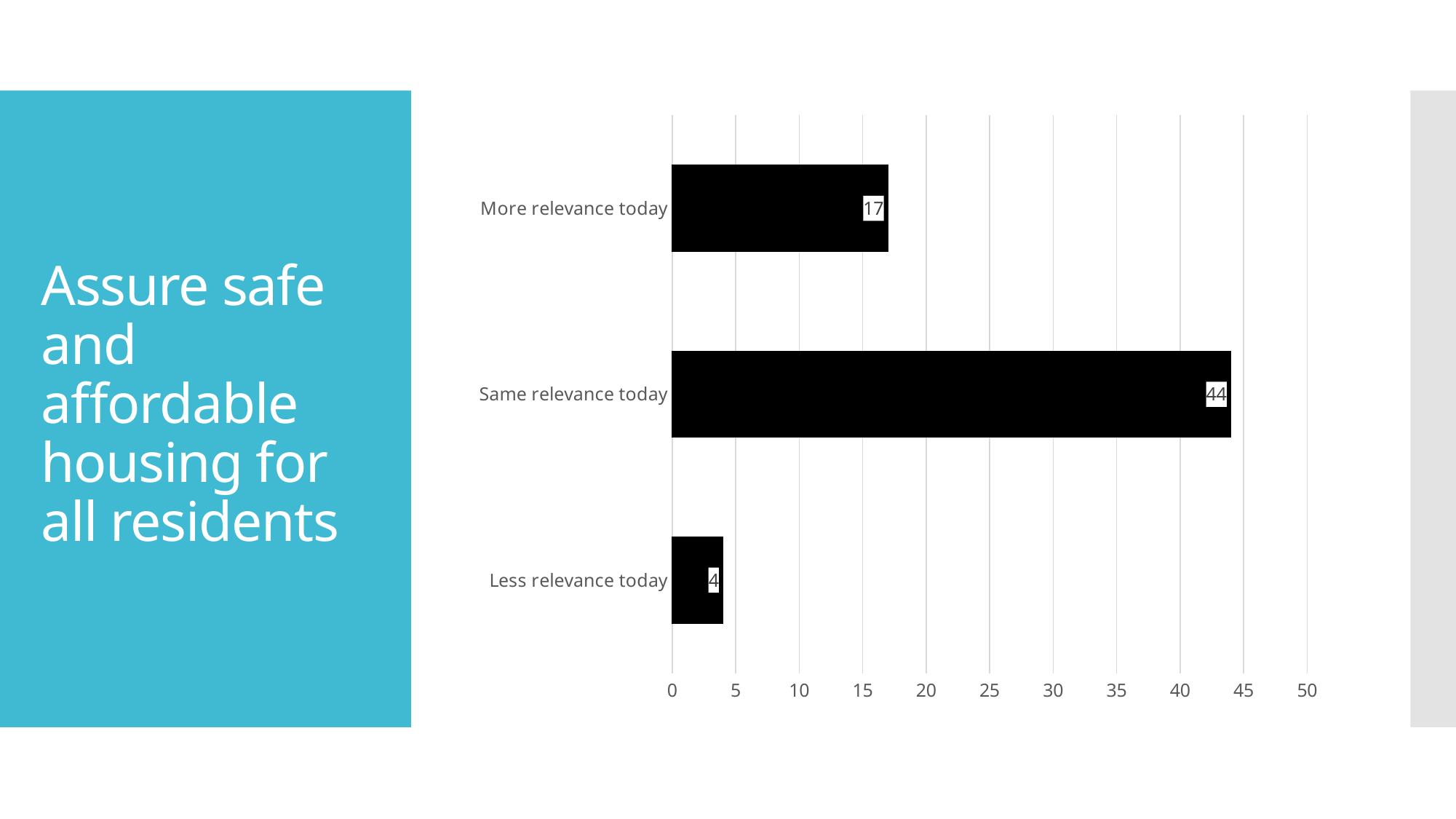
What is the value for "Less relevance today"? 4 What is the difference between the values for "More relevance today" and "Less relevance today"? 13 Which is larger, the value for "More relevance today" or "Less relevance today"? More relevance today What is the value for "More relevance today"? 17 How many categories are shown in the chart? 3 Is the value for "Same relevance today" greater or less than 40? greater Which category has the lowest value? Less relevance today What is the value for "Same relevance today"? 44 What is the difference between the values for "Same relevance today" and "More relevance today"? 27 Which category has the highest value? Same relevance today What is the highest value shown on the horizontal axis? 50 What kind of chart is shown on the slide? bar chart